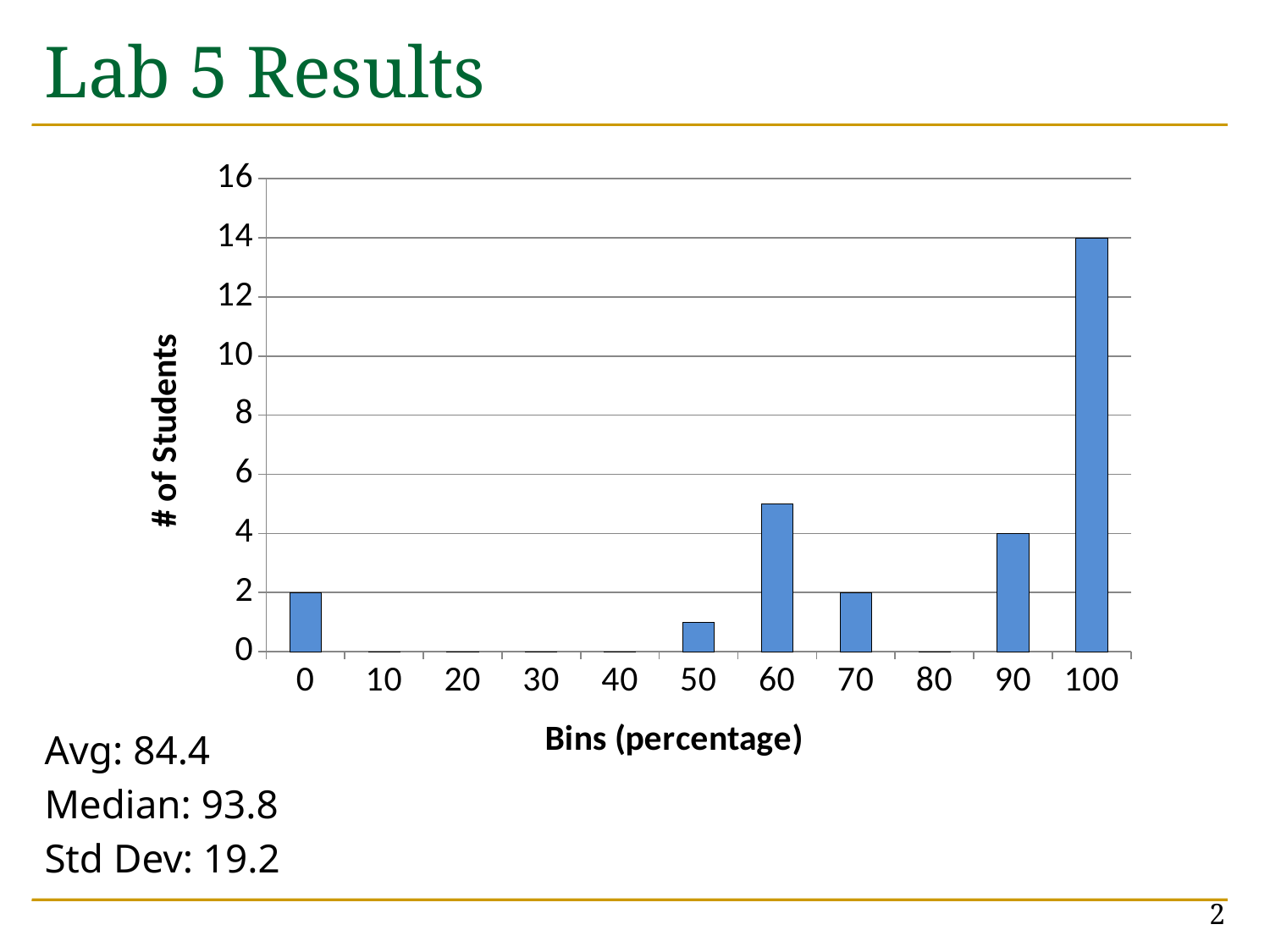
Which bin has more students, 60 or 90? 60 How many students are in the 90 bin? 4 How many students are in the 0 bin? 2 How many bins are shown on the x axis? 11 How many students are in the 70 bin? 2 How many students are in the 30 bin? 0 What is the difference in number of students between the 100 bin and the 90 bin? 10 Which bin has the highest number of students? 100 Is the number of students in the 50 bin greater or less than 2? less What type of chart is shown on the slide? bar chart Is the number of students in the 60 bin greater or less than 4? greater How many students are in the 100 bin? 14